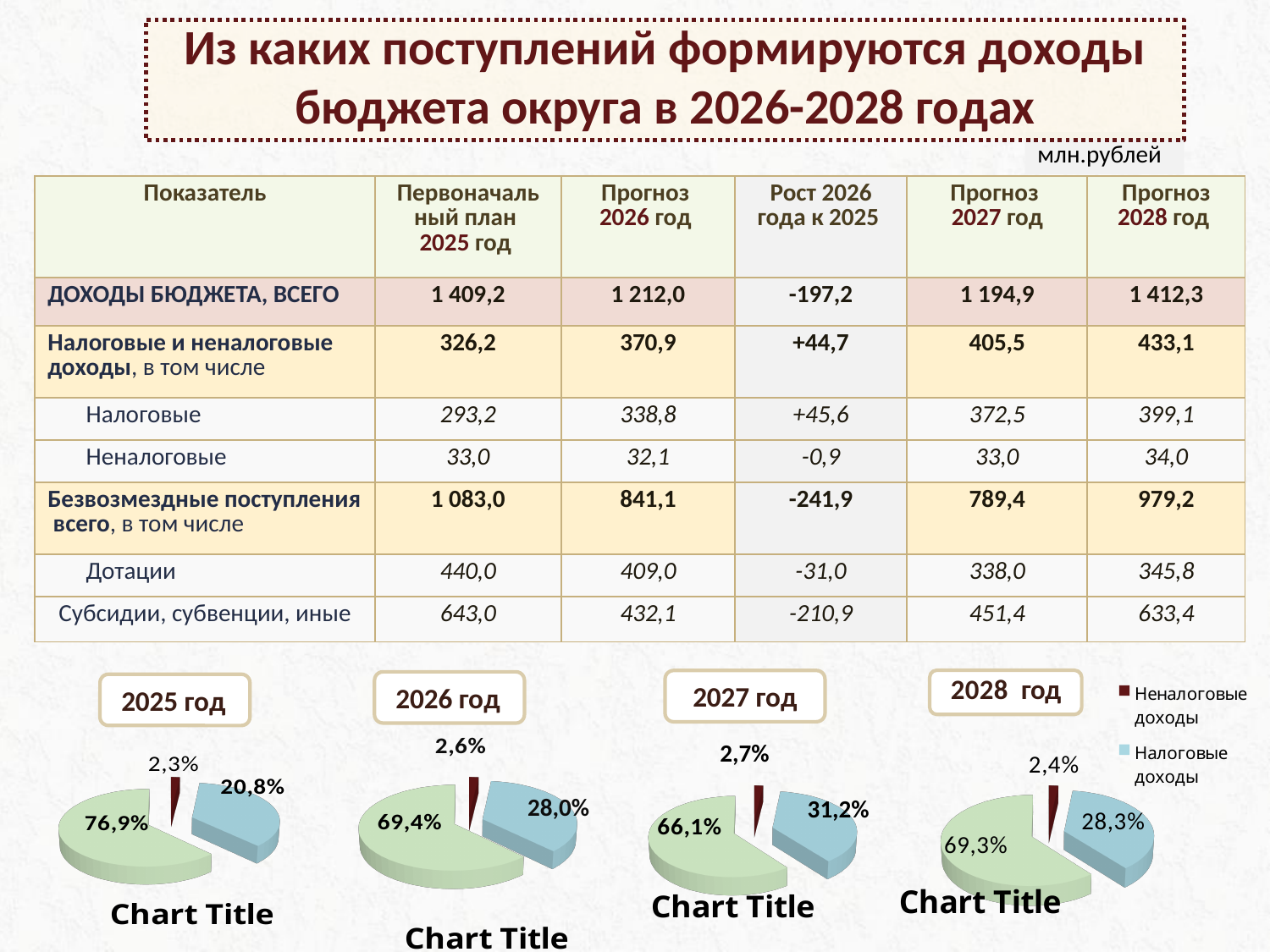
How many slices does the 2026 год pie chart have? 3 How many pie charts are shown on the slide? 4 Is the share of Налоговые доходы larger in the 2026 год pie chart or the 2027 год pie chart? 2027 год In the 2028 год pie chart, what share is shown for Неналоговые доходы? 2,4% In the 2027 год pie chart, what is the smallest share shown? 2,7% How many entries does the legend next to the 2028 год chart list? 2 In the 2026 год pie chart, what share is shown for Неналоговые доходы? 2,6% What kind of chart is used for the 2025 год chart at the bottom of the slide? Pie chart In the 2027 год pie chart, what share is shown for Налоговые доходы? 31,2% In the 2027 год pie chart, by how many percentage points does the Налоговые доходы share exceed the Неналоговые доходы share? 28,5 In the 2025 год pie chart, what is the largest share shown? 76,9% In the 2025 год pie chart, what share is shown for Налоговые доходы? 20,8%